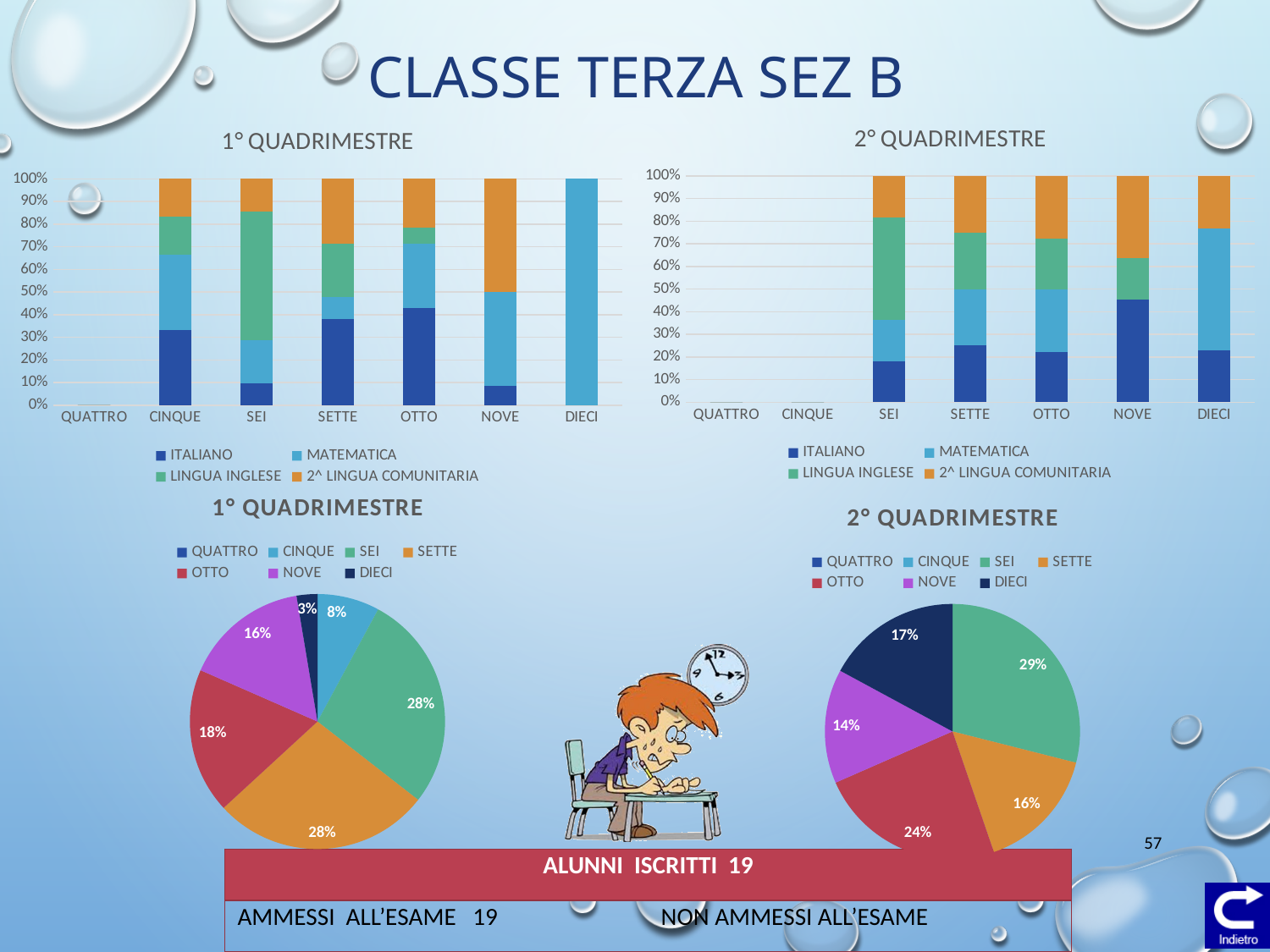
In the 1° QUADRIMESTRE pie chart, what share does SEI have? 28% How many series does the legend of the top-left 1° QUADRIMESTRE bar chart list? 4 In the 2° QUADRIMESTRE pie chart, which category has the largest slice? SEI In the 2° QUADRIMESTRE pie chart, what share does SEI have? 29% In the 1° QUADRIMESTRE pie chart, which category has the smallest slice? DIECI In the 2° QUADRIMESTRE pie chart, what is the difference between the shares of OTTO and SETTE? 8% What kind of chart is the 1° QUADRIMESTRE chart at the top left of the slide? Stacked bar chart In the 2° QUADRIMESTRE pie chart, which slice is larger, OTTO or DIECI? OTTO In the top-left 1° QUADRIMESTRE bar chart, is the ITALIANO value for NOVE greater or less than 20%? less In the 2° QUADRIMESTRE pie chart, which category has the smallest slice? NOVE In the 1° QUADRIMESTRE pie chart, what share does DIECI have? 3% In the top-right 2° QUADRIMESTRE bar chart, is the ITALIANO value for NOVE greater or less than 30%? greater